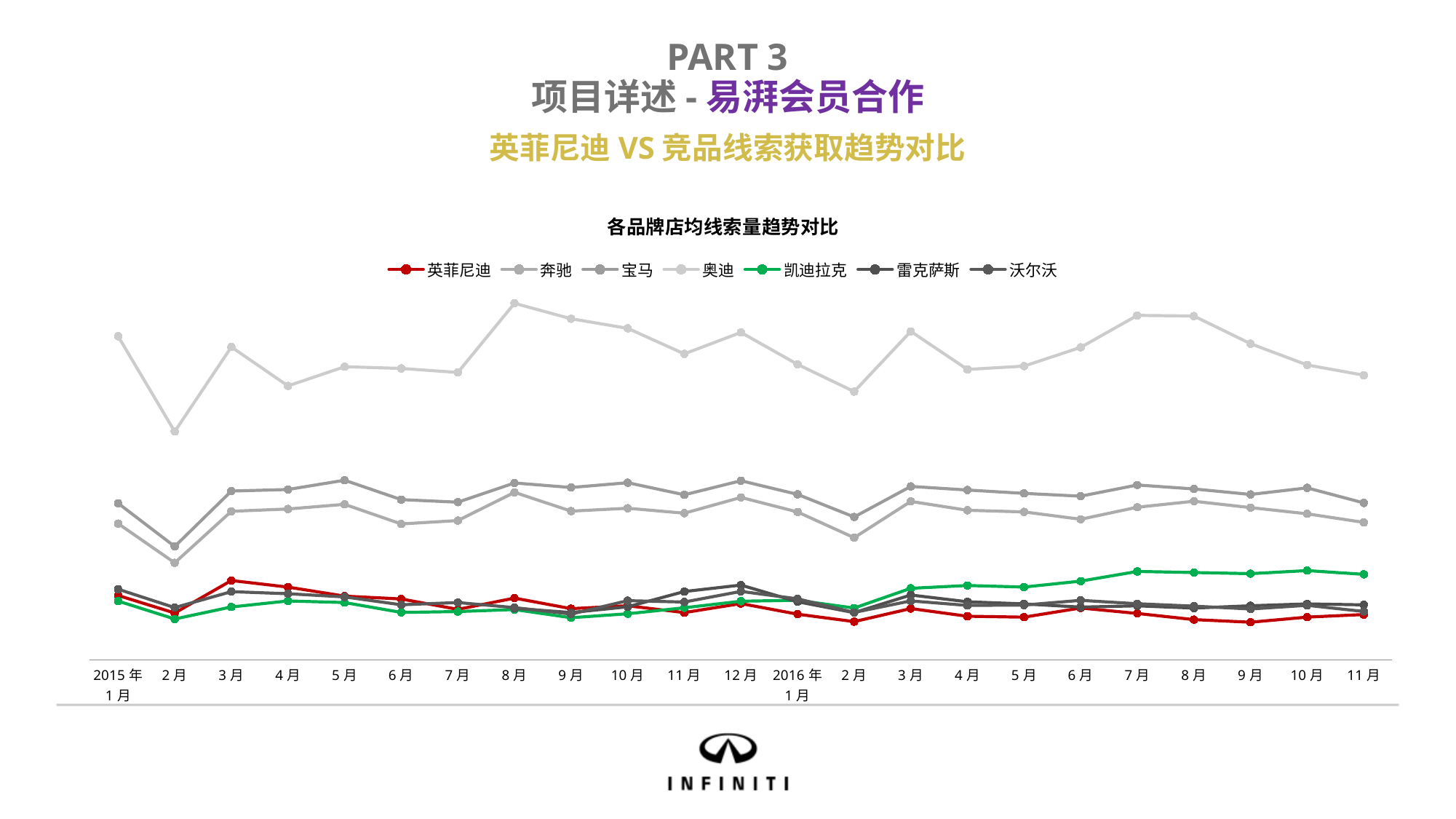
Which brand is drawn with the red line? 英菲尼迪 Does the 凯迪拉克 line rise or fall from 2016年2月 to 2016年7月? rise Does the 英菲尼迪 line rise or fall from 2015年3月 to 2015年9月? fall Which brand has the highest line across the whole chart? 奥迪 In which month does the 奥迪 line reach its lowest point? 2015年2月 How many months are plotted along the x axis? 23 What kind of chart is shown on the slide? line chart Which brand has the lowest value in 2016年9月? 英菲尼迪 What is the title of the chart? 各品牌店均线索量趋势对比 In 2016年11月, which is higher: 凯迪拉克 or 英菲尼迪? 凯迪拉克 How many series does the legend list? 7 In 2015年2月, which is higher: 奥迪 or 宝马? 奥迪